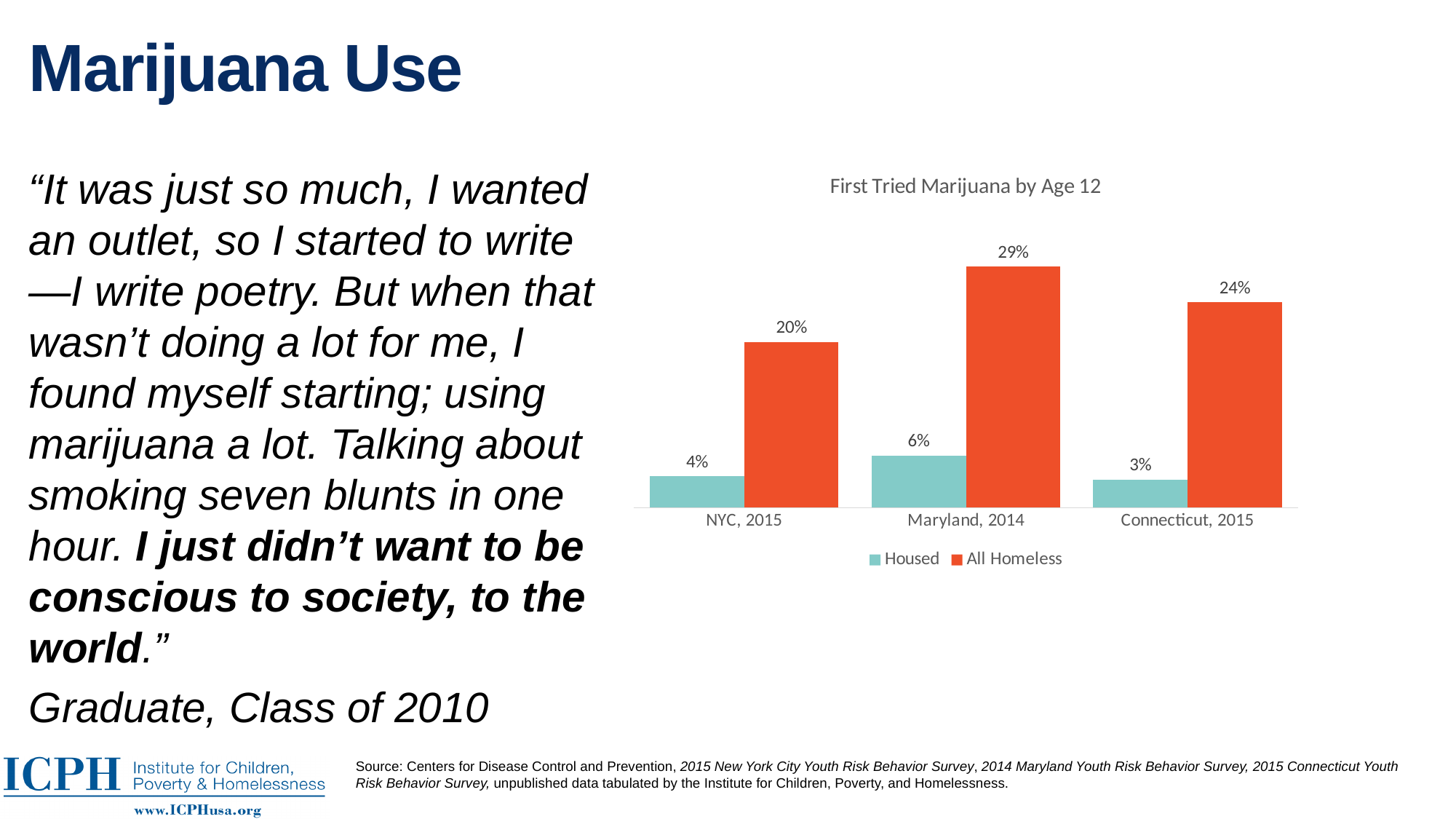
What is the value for All Homeless in Connecticut, 2015? 24% How many categories are shown on the x axis? 3 What is the difference between the All Homeless values for Maryland, 2014 and Connecticut, 2015? 5% What kind of chart is shown? Bar chart Which category has the highest All Homeless value? Maryland, 2014 What is the difference between the All Homeless and Housed values for NYC, 2015? 16% How many series does the legend list? 2 Which is larger, the Housed value for Maryland, 2014 or the Housed value for NYC, 2015? Maryland, 2014 What is the value for Housed in NYC, 2015? 4% What is the value for All Homeless in Maryland, 2014? 29% Which category has the lowest Housed value? Connecticut, 2015 What is the title of the chart? First Tried Marijuana by Age 12